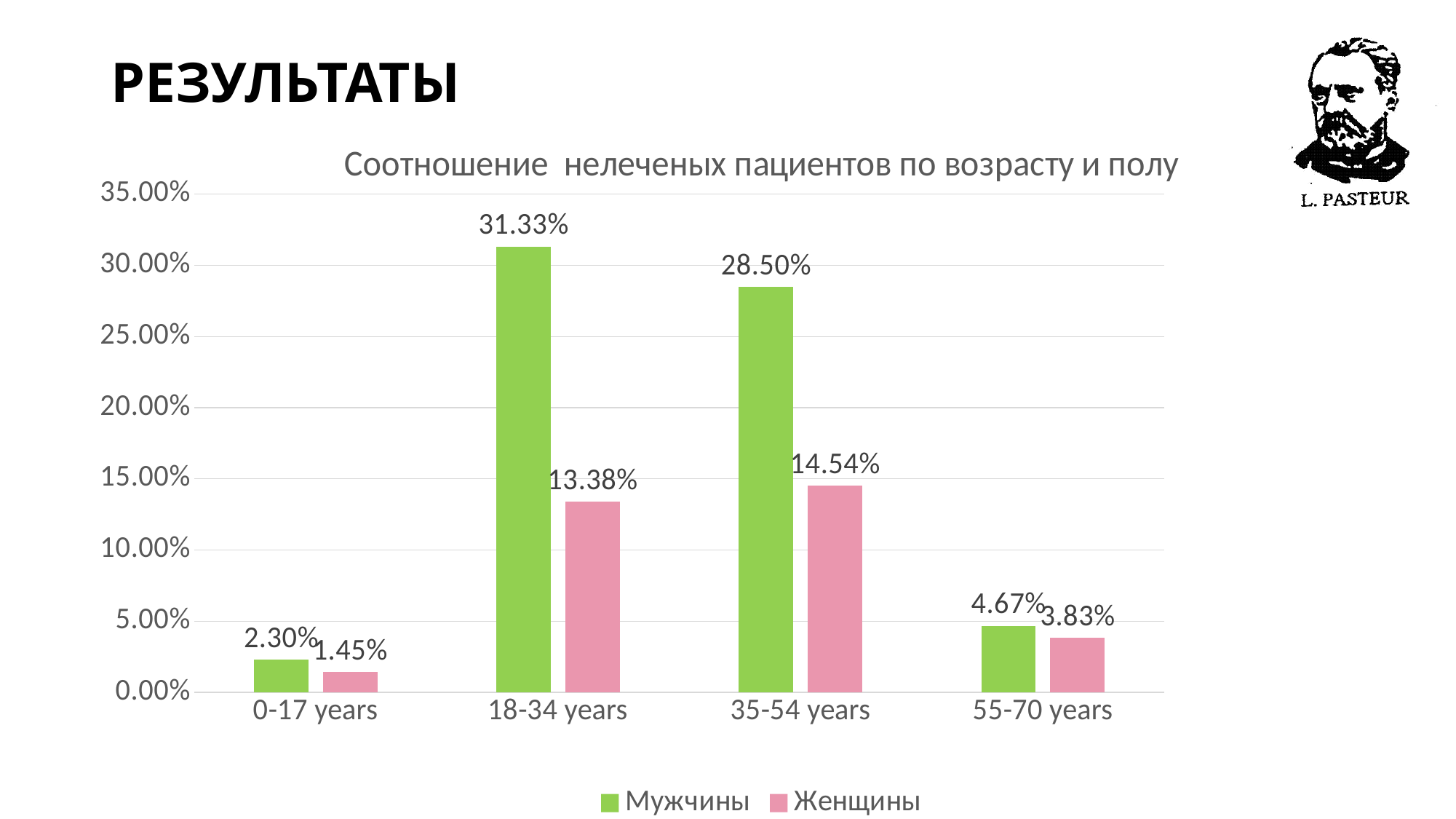
What is the title of the chart? Соотношение нелеченых пациентов по возрасту и полу What kind of chart is shown on the slide? Bar chart Which is larger in the 35-54 years category, Мужчины or Женщины? Мужчины How many age categories are shown on the x axis? 4 What is the value for Женщины in the 0-17 years category? 1.45% Which age category has the lowest value for Женщины? 0-17 years What is the value for Женщины in the 35-54 years category? 14.54% What is the difference between Мужчины and Женщины in the 18-34 years category? 17.95% Which age category has the highest value for Мужчины? 18-34 years What is the value for Мужчины in the 55-70 years category? 4.67% How many series does the legend list? 2 What is the value for Мужчины in the 18-34 years category? 31.33%